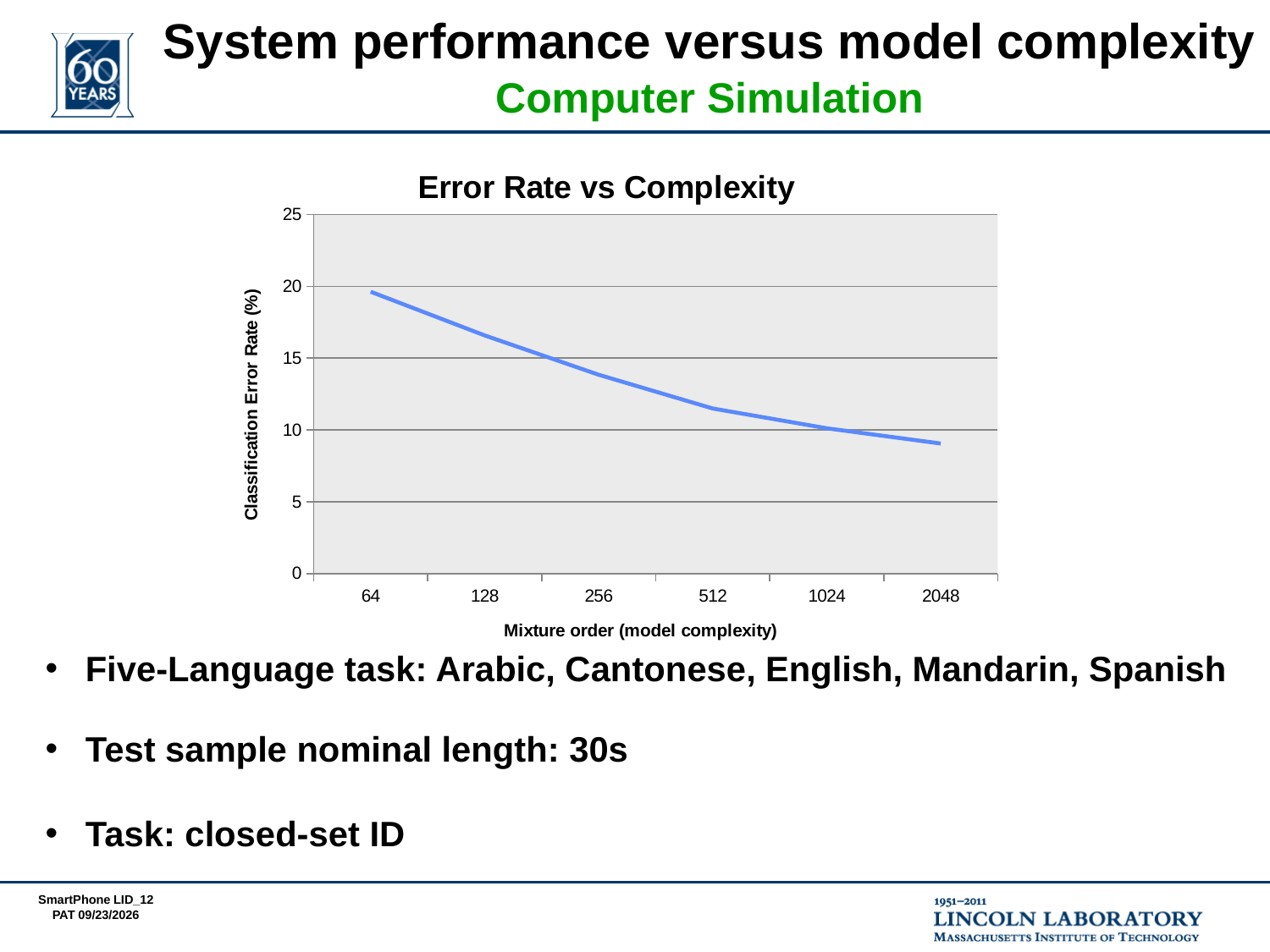
What kind of chart is shown on the slide? line chart How many mixture order values are plotted on the x axis? 6 Which has the higher classification error rate, mixture order 128 or mixture order 512? 128 At which mixture order is the classification error rate highest? 64 Is the classification error rate at mixture order 256 greater or less than 15? less What is the label of the y axis of the chart? Classification Error Rate (%) Is the classification error rate at mixture order 512 greater or less than 10? greater Does the classification error rate rise or fall as the mixture order increases? fall At which mixture order is the classification error rate lowest? 2048 Is the classification error rate at mixture order 64 greater or less than 15? greater What is the title of the chart? Error Rate vs Complexity